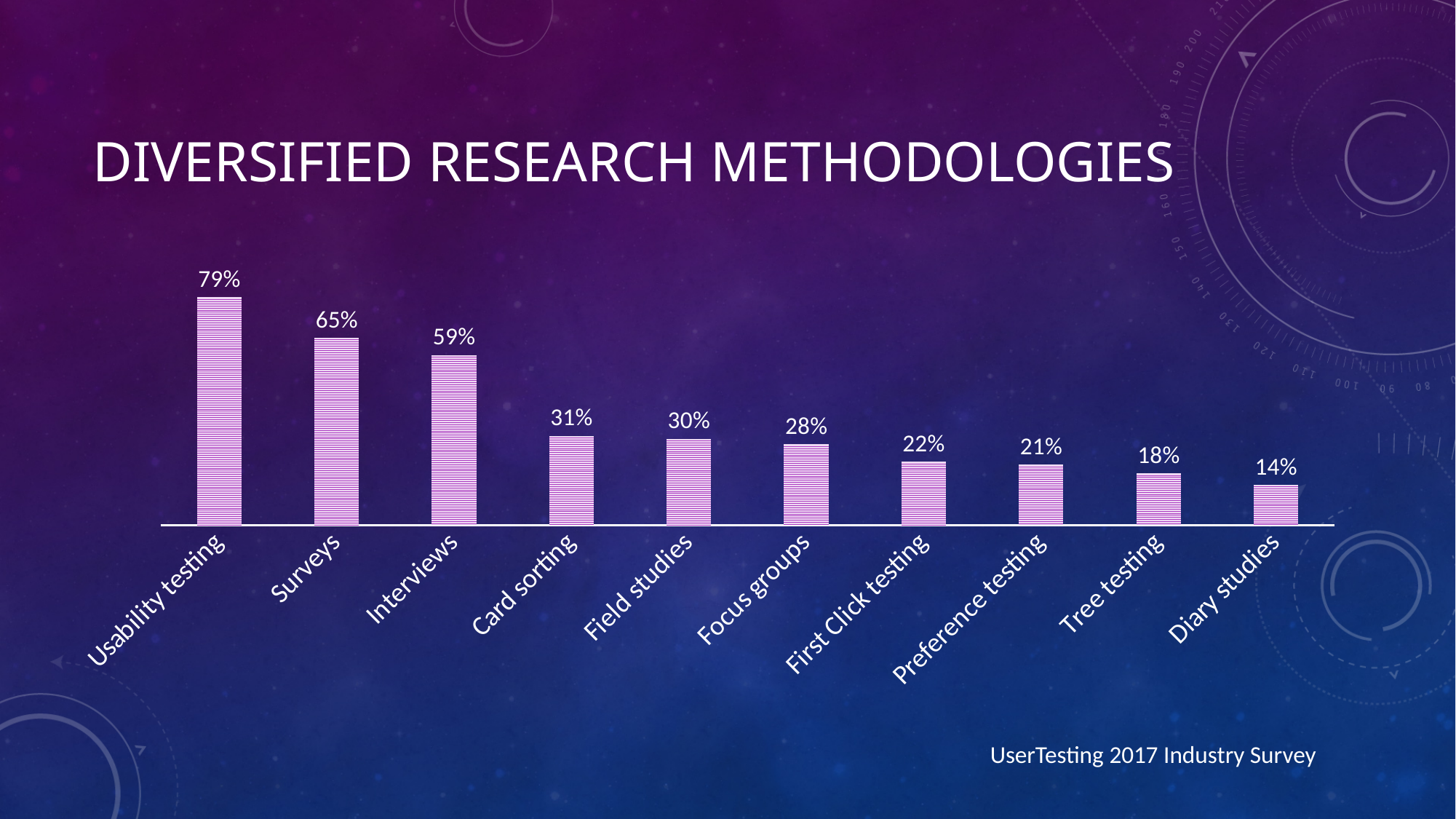
What is the title of the slide containing the chart? Diversified Research Methodologies Do the values rise or fall from left to right along the x axis? Fall What is the difference between the values for Usability testing and Diary studies? 65% How many research methodologies are shown in the chart? 10 What is the value for Usability testing? 79% What is the difference between the values for Surveys and Interviews? 6% What is the value for Card sorting? 31% Which has a larger value, Focus groups or First Click testing? Focus groups Which research methodology has the lowest value? Diary studies Which research methodology has the highest value? Usability testing What kind of chart is shown on the slide? Bar chart What is the value for Tree testing? 18%